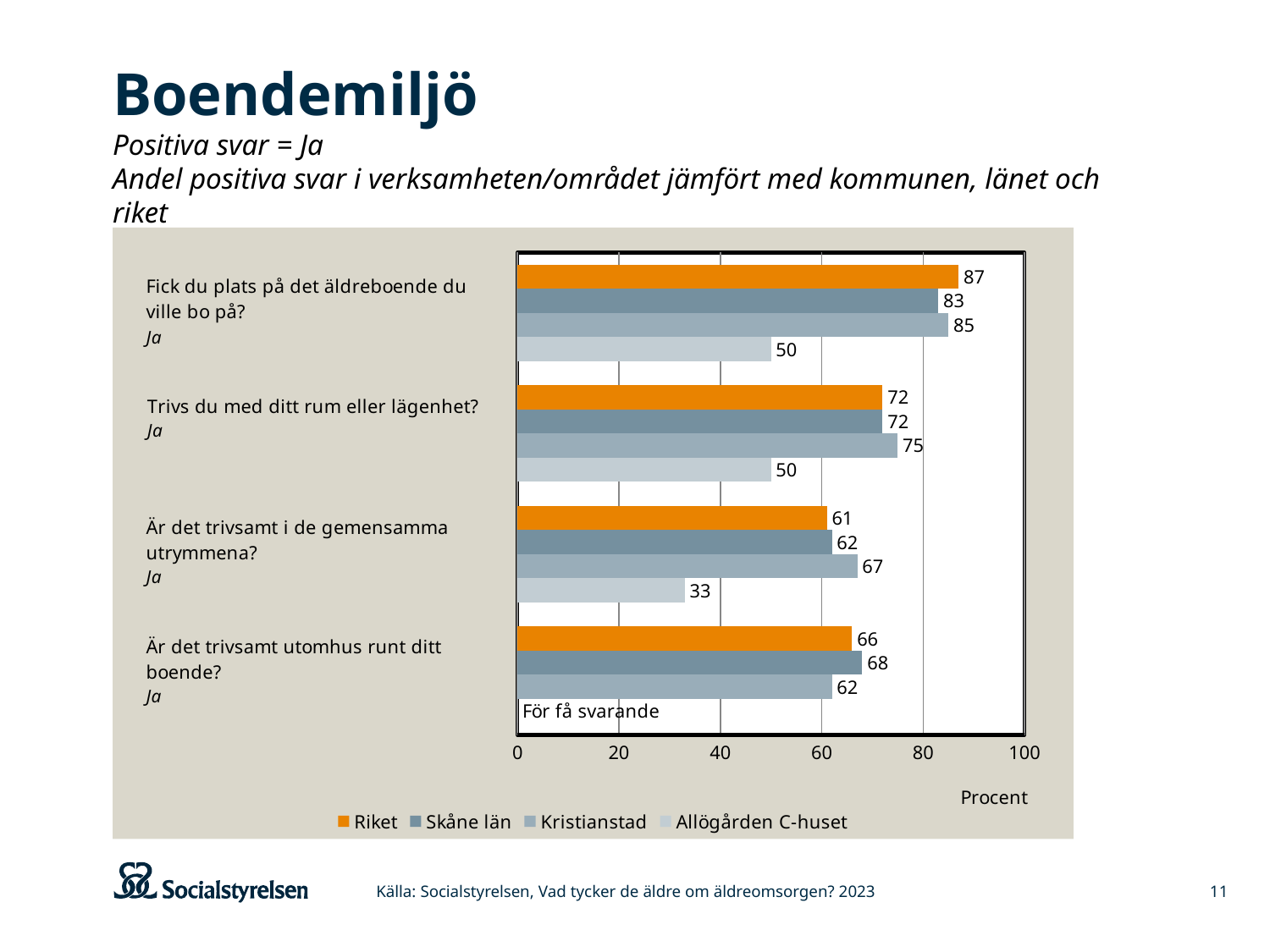
Which series has the lowest value on "Är det trivsamt i de gemensamma utrymmena?"? Allögården C-huset Which series has the highest value on "Fick du plats på det äldreboende du ville bo på?"? Riket What kind of chart is shown on the slide? Bar chart What is the value for Kristianstad on "Trivs du med ditt rum eller lägenhet?"? 75 What is the difference between Kristianstad and Allögården C-huset on "Fick du plats på det äldreboende du ville bo på?"? 35 What is the value for Riket on "Fick du plats på det äldreboende du ville bo på?"? 87 What is shown instead of a value for Allögården C-huset on "Är det trivsamt utomhus runt ditt boende?"? För få svarande What is the value for Skåne län on "Är det trivsamt utomhus runt ditt boende?"? 68 Which is larger on "Är det trivsamt utomhus runt ditt boende?": Riket or Kristianstad? Riket How many series does the legend list? 4 How many question categories are shown in the chart? 4 What is the value for Allögården C-huset on "Är det trivsamt i de gemensamma utrymmena?"? 33